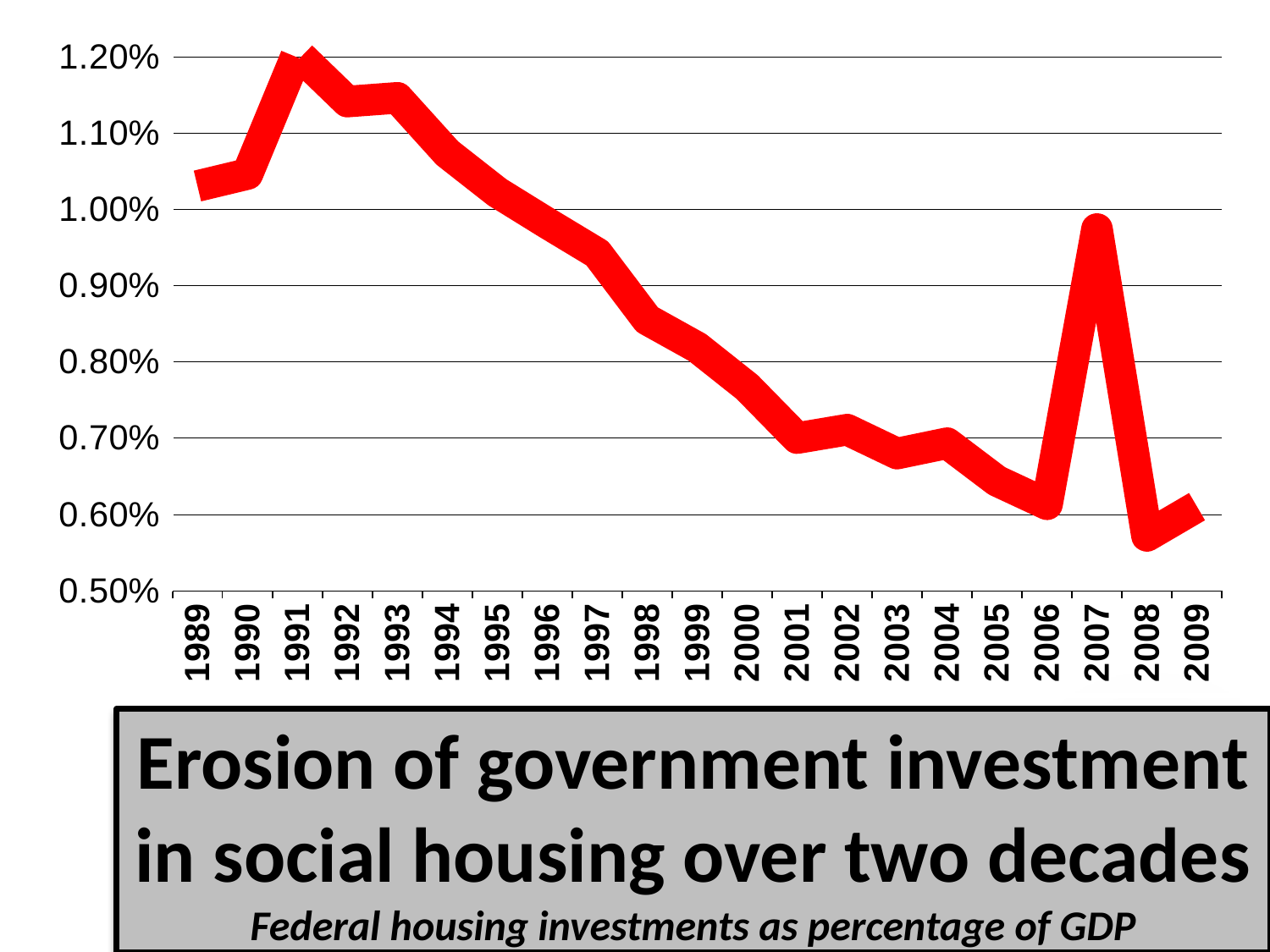
How many years are plotted along the x axis? 21 Is the value for 2008 greater or less than 0.60%? less Is the value for 1991 greater or less than 1.10%? greater Which year has the lowest value? 2008 Overall, do the values rise or fall from 1989 to 2009? fall Which year has the larger value, 1994 or 2005? 1994 What kind of chart is shown on the slide? line chart Which year has the larger value, 1991 or 2007? 1991 What is the subtitle describing what the chart measures? Federal housing investments as percentage of GDP Is the value for 2001 greater or less than 0.80%? less Which year has the highest value? 1991